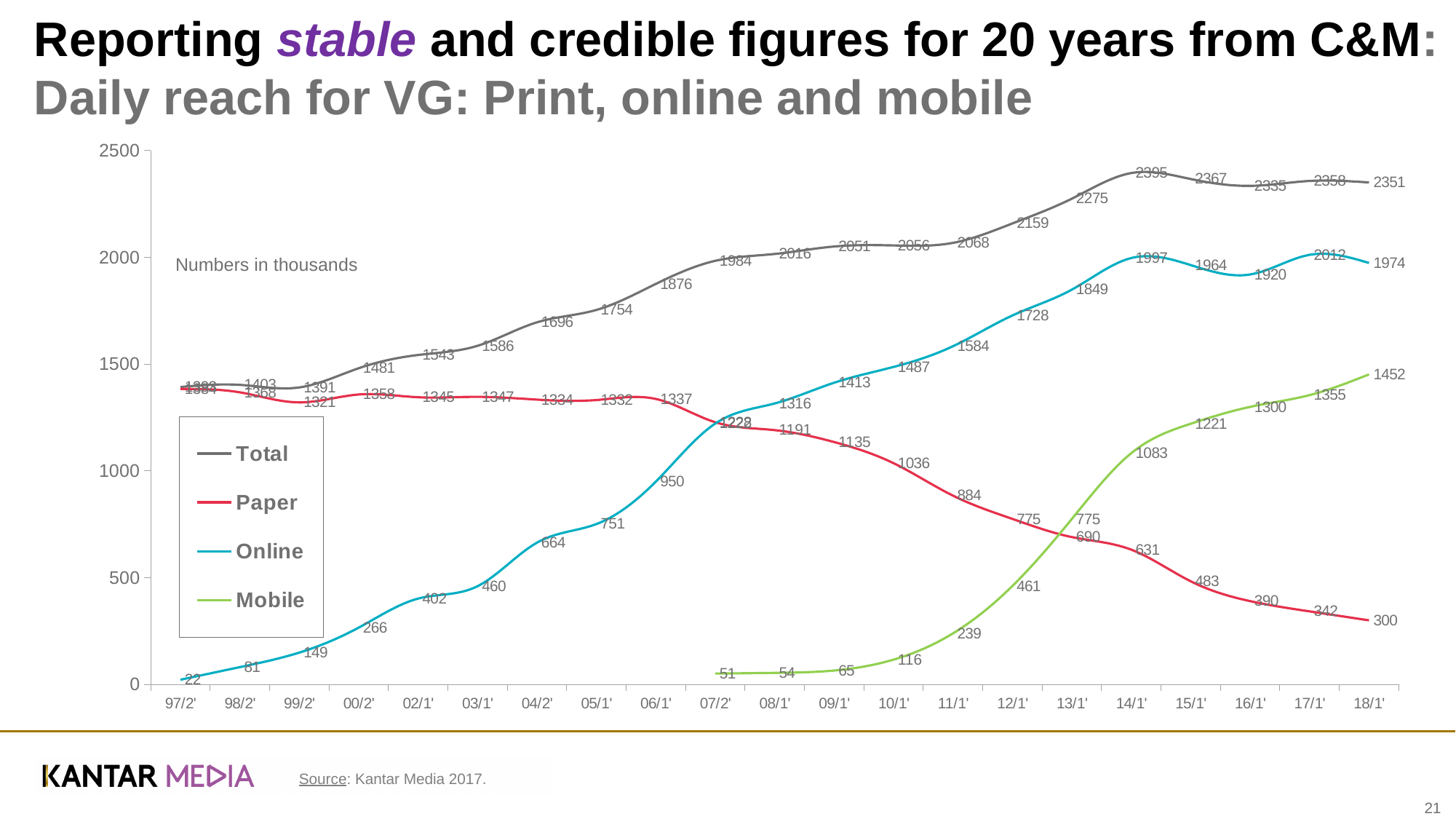
What is the Online value for 06/1'? 950 In which period is the Mobile series lowest? 07/2' How many periods are shown on the x axis? 21 What is the Paper value for 18/1'? 300 Which is larger in 13/1', the Paper value or the Mobile value? Mobile How many series does the legend list? 4 Does the Paper series rise or fall from 06/1' to 18/1'? fall What is the difference between the Online value and the Paper value in 18/1'? 1674 What is the Mobile value for 12/1'? 461 What is the Total value for 14/1'? 2395 In which period does the Total series reach its highest value? 14/1' What type of chart is shown on the slide? line chart